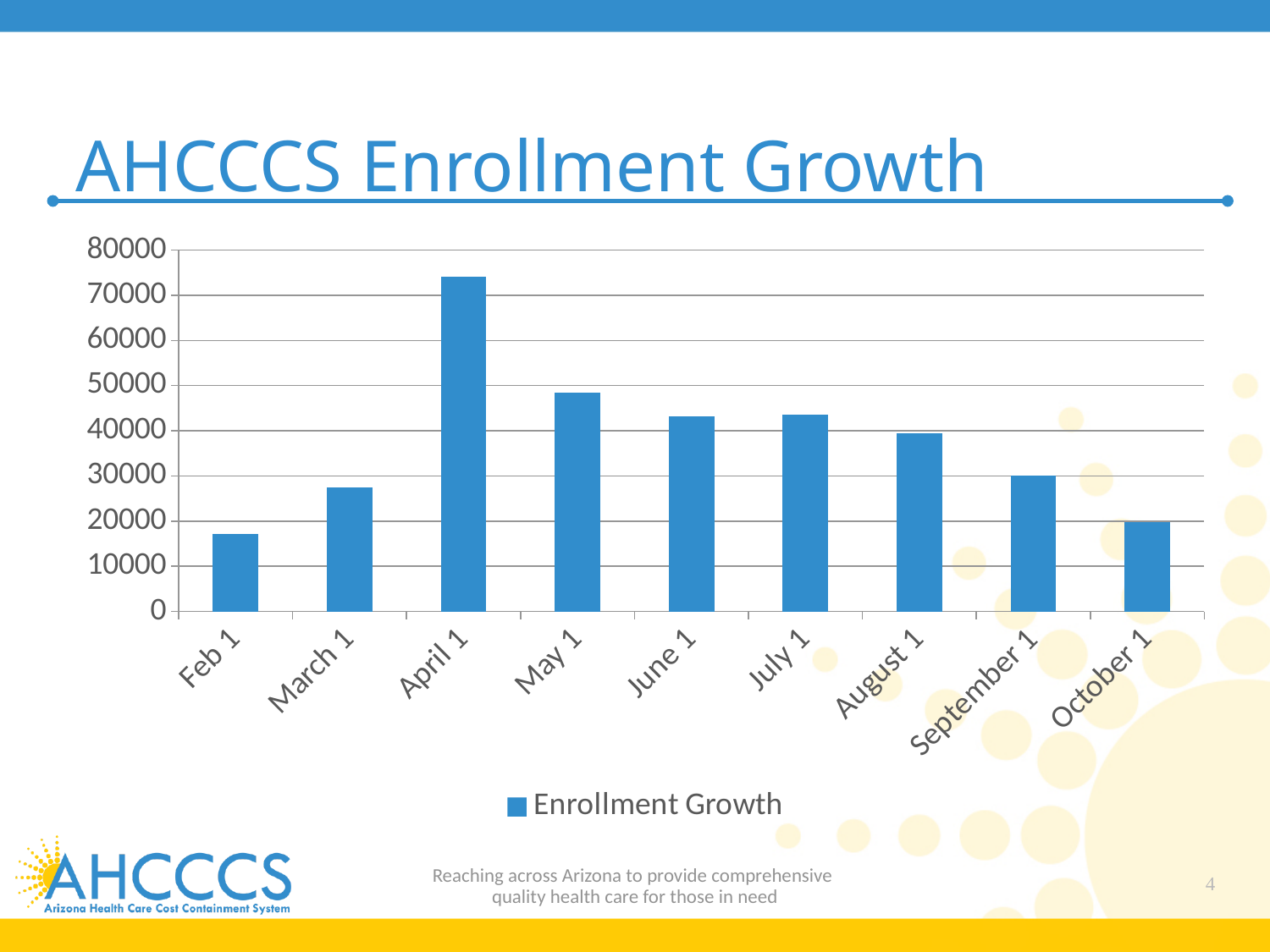
What kind of chart is shown on the slide? bar chart Do the values rise or fall from April 1 to October 1? fall What is the title of the slide? AHCCCS Enrollment Growth How many months are shown on the x axis? 9 Is the value for October 1 greater or less than 30000? less Which month has the lowest enrollment growth? Feb 1 Which month has the highest enrollment growth? April 1 Is the value for Feb 1 greater or less than 20000? less Is the value for April 1 greater or less than 70000? greater How many series does the legend list? 1 Which is larger, the value for April 1 or the value for May 1? April 1